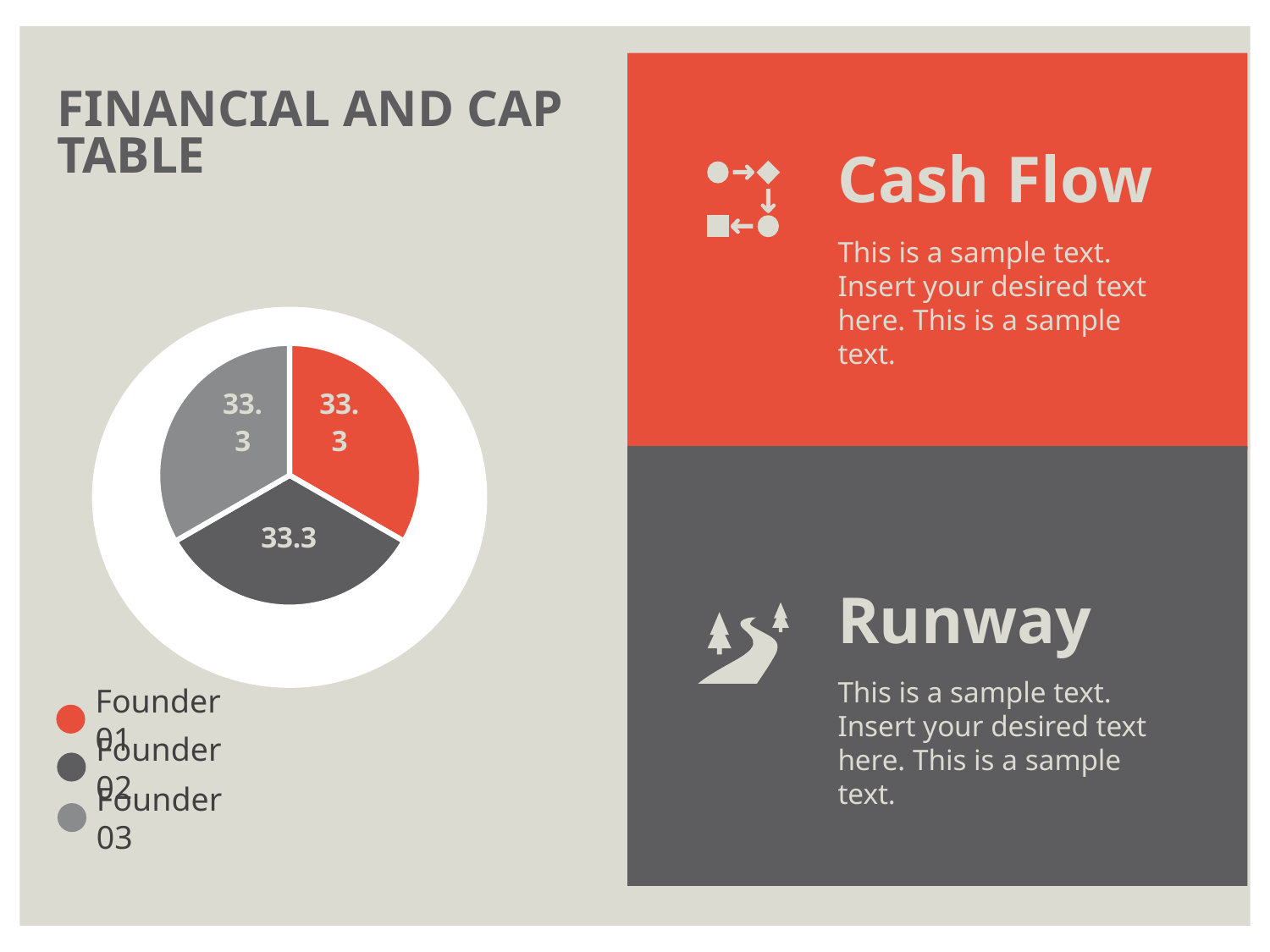
Are the values for Founder 01 and Founder 03 in the pie chart equal? yes What value is shown for Founder 01 in the pie chart? 33.3 Is the value for Founder 02 in the pie chart greater or less than 50? less What value is shown for Founder 03 in the pie chart? 33.3 What is the difference between the values for Founder 01 and Founder 02 in the pie chart? 0 How many entries does the legend of the pie chart list? 3 Which colour represents Founder 01 in the pie chart? red How many slices does the pie chart have? 3 What kind of chart is shown on the slide? pie chart What value is shown for Founder 02 in the pie chart? 33.3 Which legend entry is shown in light grey in the pie chart? Founder 03